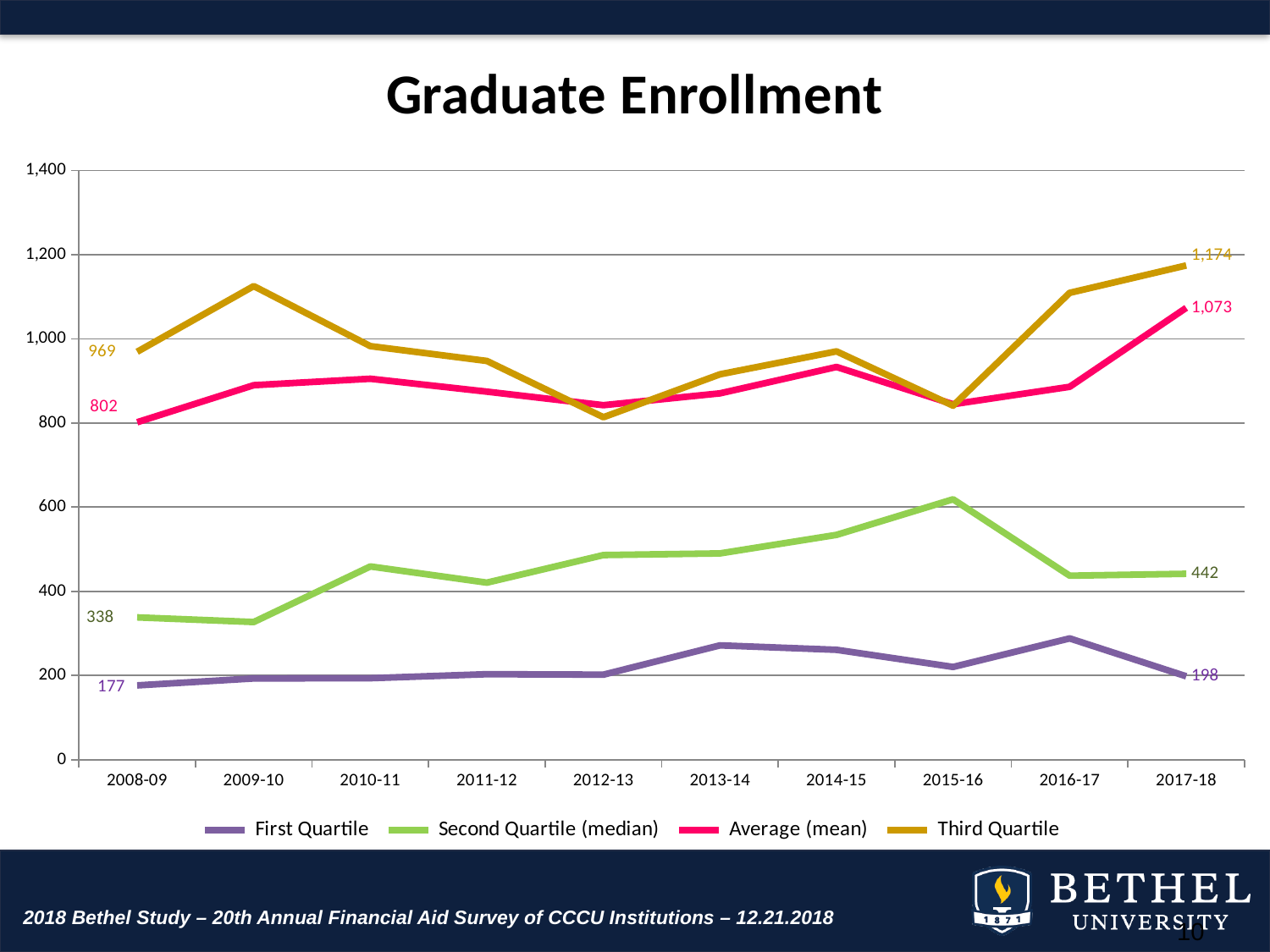
Which series has the lowest values across all years? First Quartile What is the title of the chart? Graduate Enrollment How many academic years are plotted along the x axis? 10 By how much did the Average (mean) change from 2008-09 to 2017-18? 271 Is the Second Quartile (median) value for 2015-16 greater or less than 600? greater What is the Third Quartile value for 2017-18? 1,174 What is the First Quartile value for 2008-09? 177 What is the Second Quartile (median) value for 2017-18? 442 What is the Average (mean) value for 2008-09? 802 What type of chart is shown on the slide? line chart Which is larger in 2017-18, the Third Quartile or the Average (mean)? Third Quartile How many series does the legend list? 4